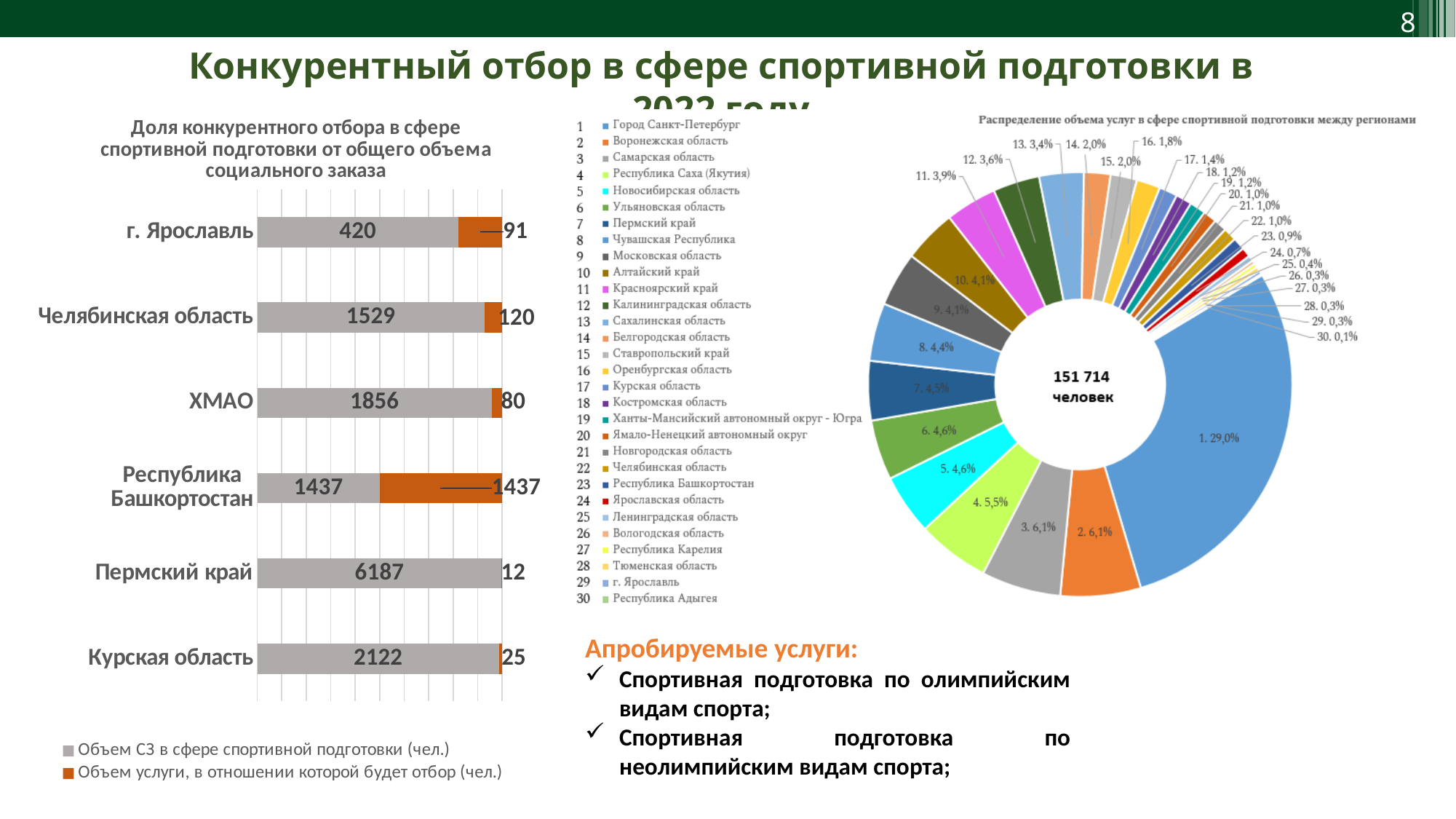
On the bar chart on the left, which is larger: the 'Объем услуги, в отношении которой будет отбор' value for г. Ярославль or for ХМАО? г. Ярославль On the bar chart on the left, what is the total of the two stacked values for Республика Башкортостан? 2874 What type of chart is the chart on the left of the slide? Bar chart On the bar chart on the left, which region has the highest value of 'Объем СЗ в сфере спортивной подготовки (чел.)'? Пермский край On the bar chart on the left, what is the value of 'Объем услуги, в отношении которой будет отбор (чел.)' for Челябинская область? 120 On the bar chart on the left, what is the value of 'Объем СЗ в сфере спортивной подготовки (чел.)' for Пермский край? 6187 What total number of people is shown in the centre of the pie chart 'Распределение объема услуг в сфере спортивной подготовки между регионами'? 151 714 человек On the pie chart 'Распределение объема услуг в сфере спортивной подготовки между регионами', what share does slice 1 (Город Санкт-Петербург) have? 29,0% How many regions are shown on the bar chart on the left? 6 On the bar chart on the left, which region has the lowest value of 'Объем услуги, в отношении которой будет отбор (чел.)'? Пермский край On the bar chart on the left, what is the difference between the 'Объем СЗ' values for Курская область and ХМАО? 266 How many series does the legend of the bar chart on the left list? 2